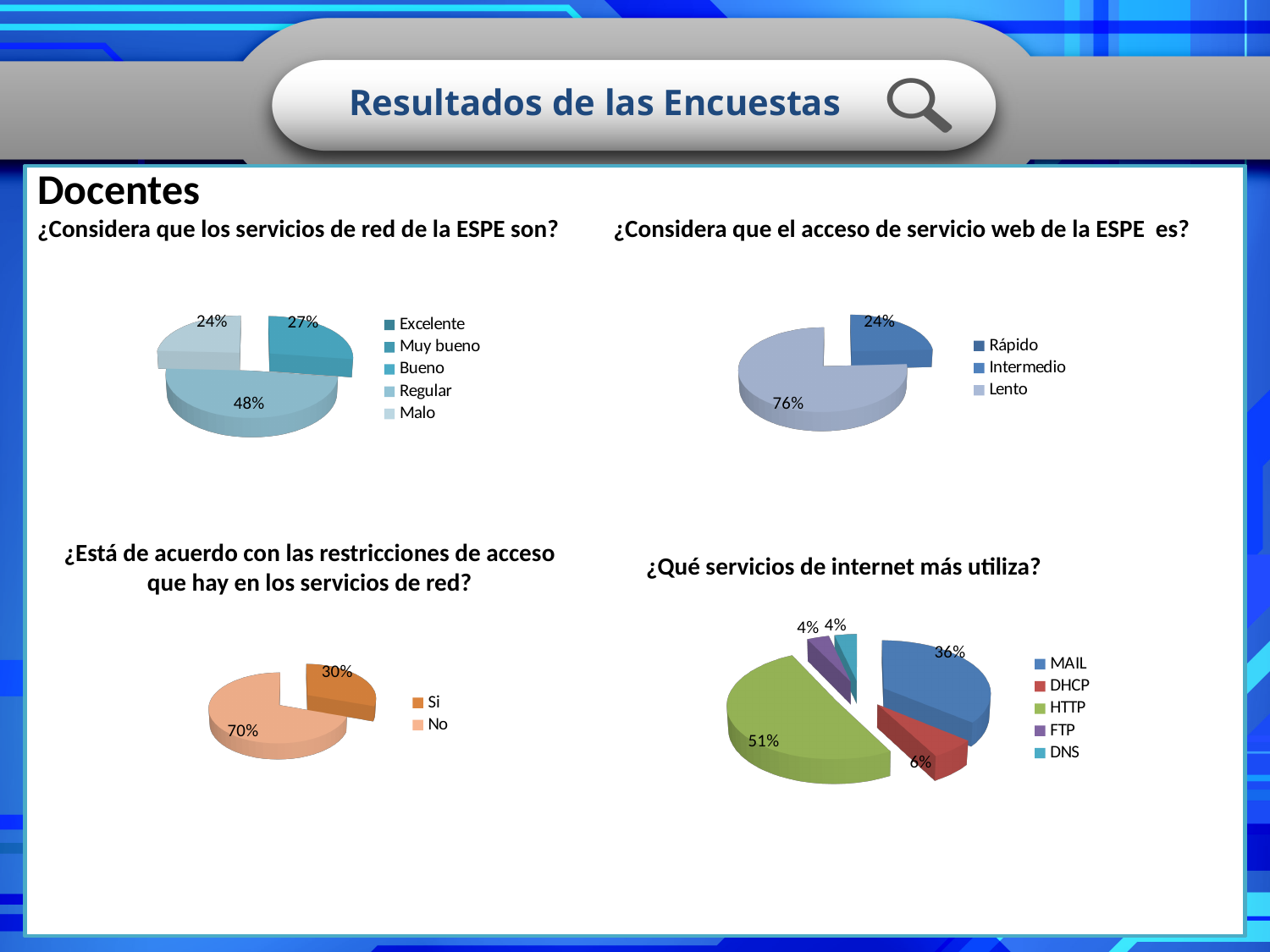
In the chart '¿Está de acuerdo con las restricciones de acceso que hay en los servicios de red?', what percentage answered 'No'? 70% What type of chart is used for '¿Considera que los servicios de red de la ESPE son?'? Pie chart In the chart '¿Considera que los servicios de red de la ESPE son?', what is the largest percentage shown on a slice? 48% In the chart '¿Qué servicios de internet más utiliza?', which service has the largest share? HTTP In the chart '¿Considera que el acceso de servicio web de la ESPE es?', what percentage is shown for Lento? 76% How many entries does the legend of the chart '¿Qué servicios de internet más utiliza?' list? 5 In the chart '¿Qué servicios de internet más utiliza?', what is the difference between the HTTP and MAIL shares? 15% In the chart '¿Está de acuerdo con las restricciones de acceso que hay en los servicios de red?', which answer is larger, Si or No? No How many entries does the legend of the chart '¿Considera que los servicios de red de la ESPE son?' list? 5 In the chart '¿Qué servicios de internet más utiliza?', what percentage is shown for MAIL? 36% In the chart '¿Qué servicios de internet más utiliza?', what percentage is shown for HTTP? 51%